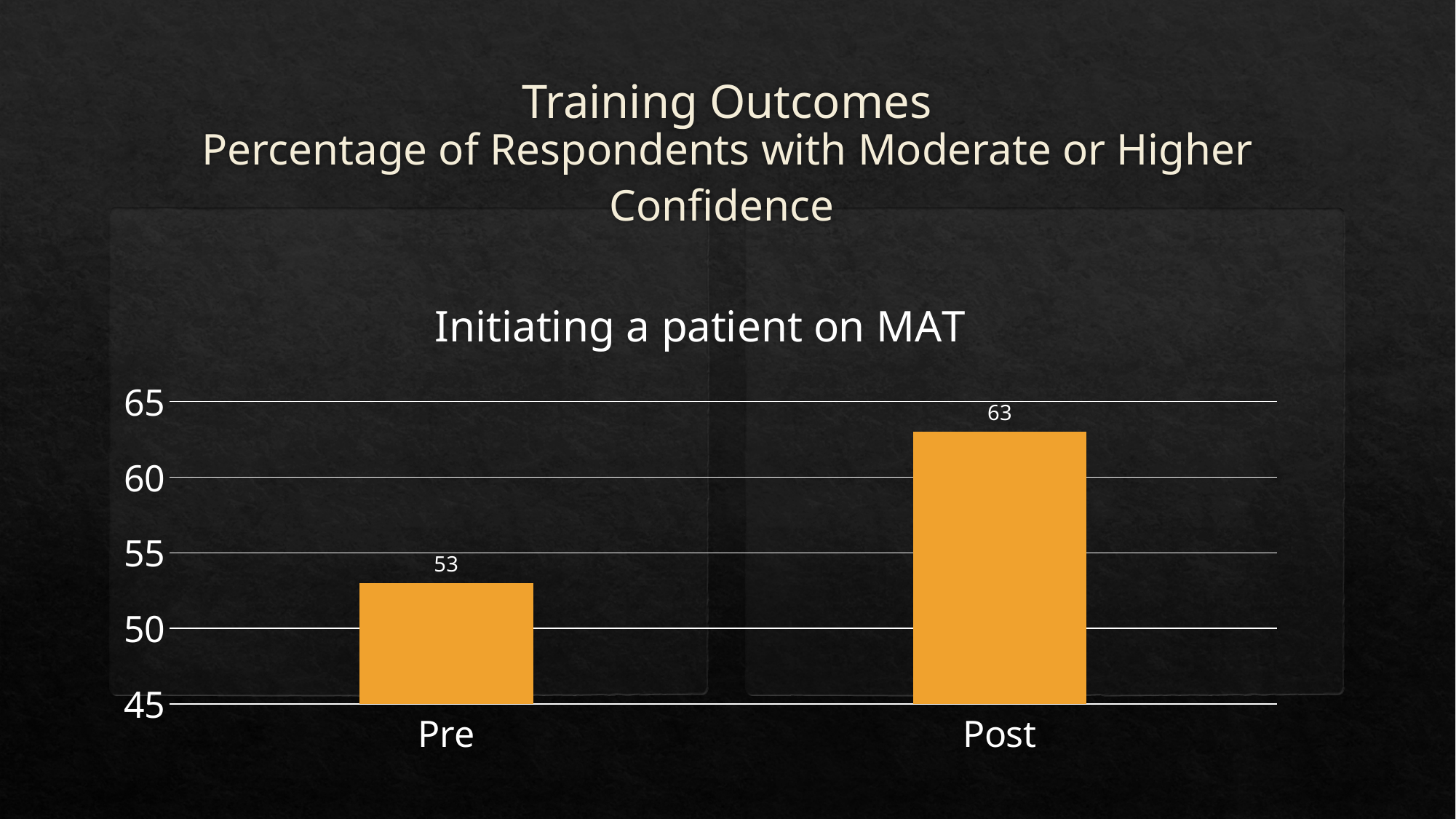
What kind of chart is shown? bar chart What is the title of the chart? Initiating a patient on MAT What is the value for Post? 63 Which category has the highest value? Post Is the value for Post greater or less than 60? greater Which is larger, the value for Pre or the value for Post? Post What is the difference between the Post and Pre values? 10 How many categories are shown on the x axis? 2 Is the value for Pre greater or less than 55? less Do the values rise or fall from Pre to Post? rise Which category has the lowest value? Pre What is the value for Pre? 53